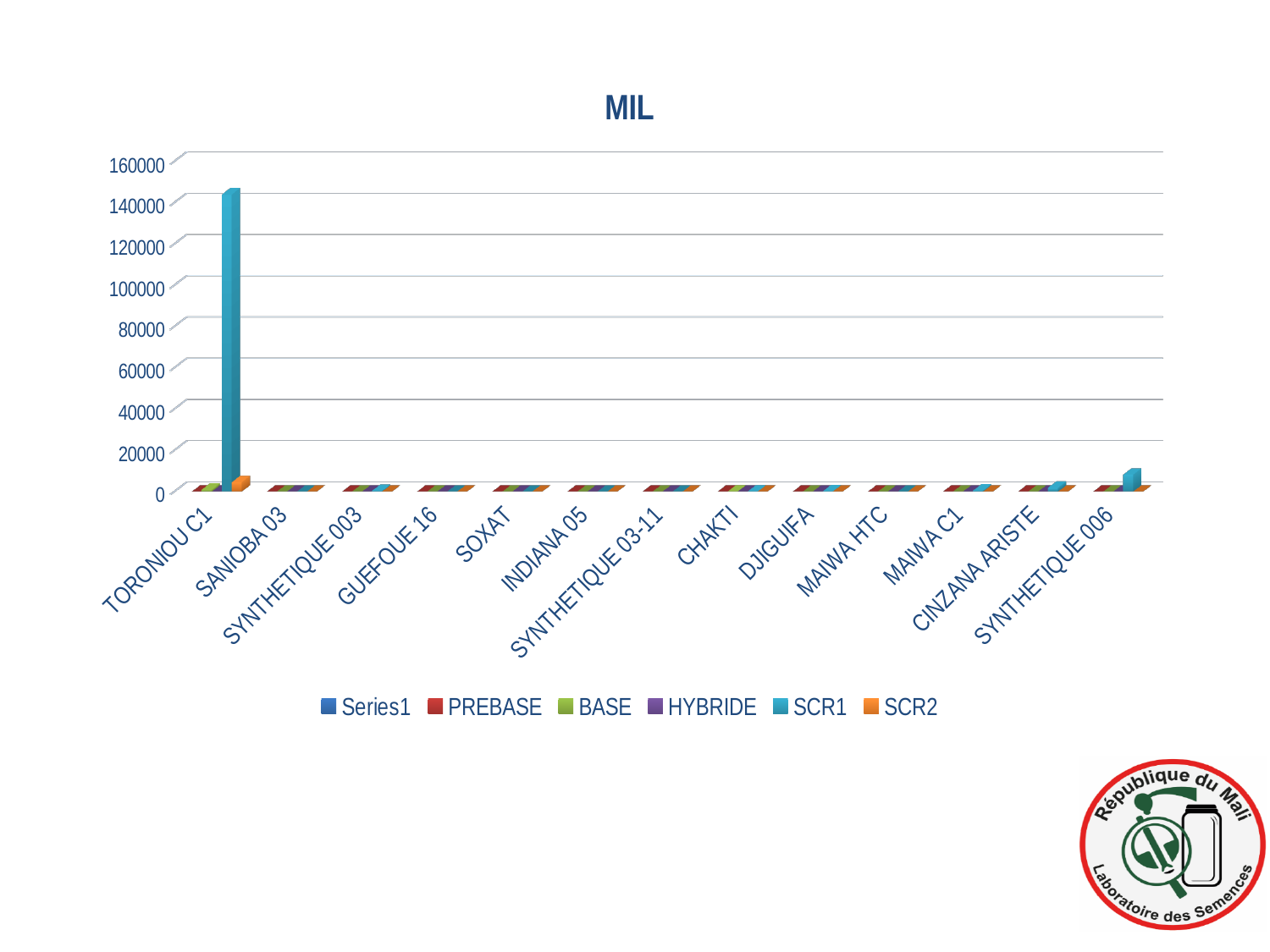
Which has the larger SCR1 value, SYNTHETIQUE 006 or CINZANA ARISTE? SYNTHETIQUE 006 What is the title of the chart? MIL How many series does the legend list? 6 How many categories are shown along the x axis of the chart? 13 What kind of chart is shown on the slide? bar chart Is the SCR1 value for TORONIOU C1 greater or less than 100000? greater Which series does the tallest bar in the chart belong to? SCR1 Which has the larger SCR1 value, TORONIOU C1 or SYNTHETIQUE 006? TORONIOU C1 Which category has the tallest bar in the chart? TORONIOU C1 Is the SCR1 value for SYNTHETIQUE 006 greater or less than 20000? less Is the SCR2 value for TORONIOU C1 greater or less than 20000? less